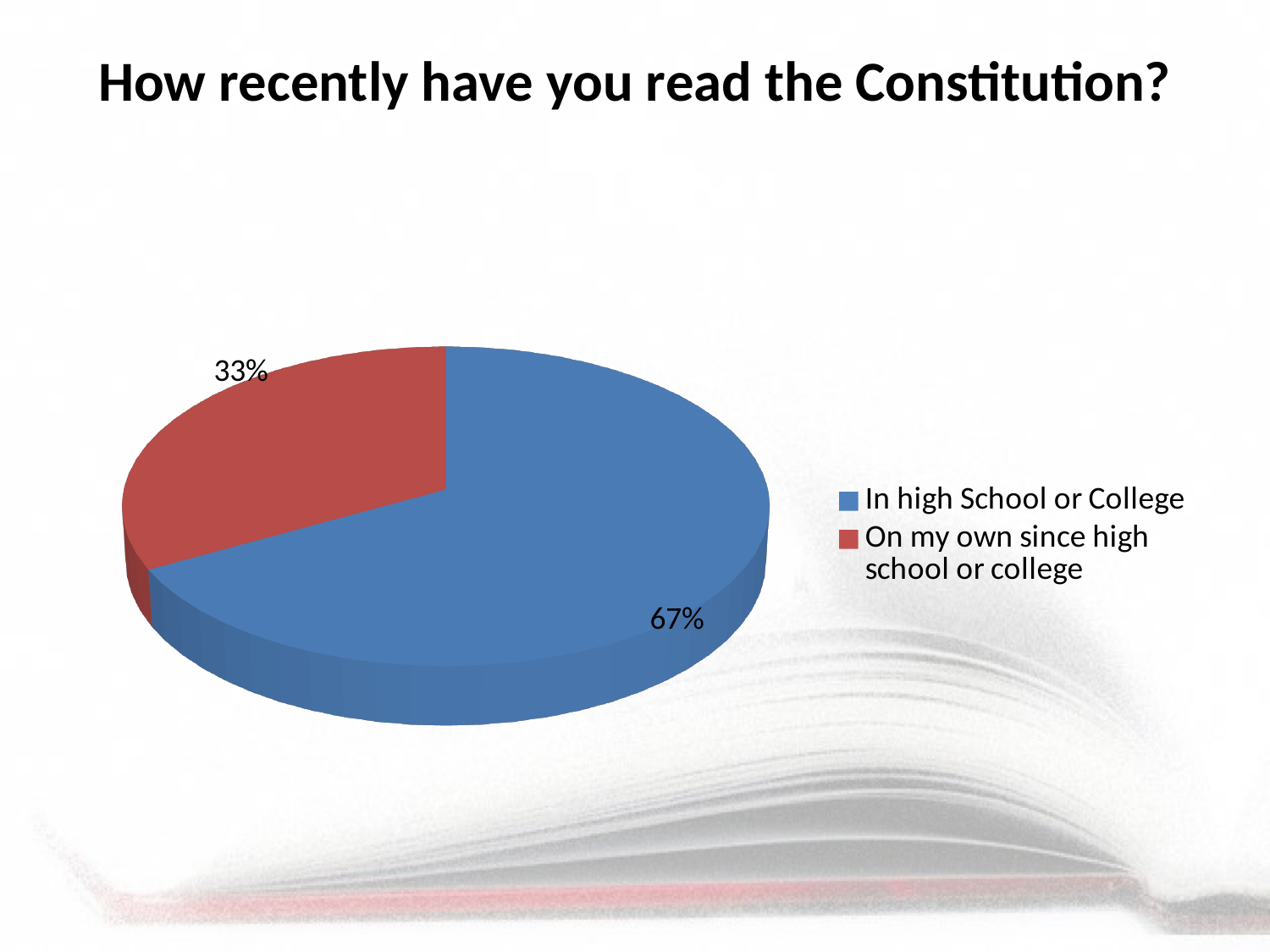
What is the title of the slide? How recently have you read the Constitution? Which category has the largest share of the pie? In high School or College What kind of chart is shown on the slide? Pie chart How many entries does the legend list? 2 How many slices does the pie chart have? 2 What share of the pie does the red slice represent? 33% What percentage of respondents read the Constitution in high school or college? 67% What colour is the slice for 'In high School or College'? Blue What percentage of respondents read the Constitution on their own since high school or college? 33% What is the difference in percentage points between the 'In high School or College' slice and the 'On my own since high school or college' slice? 34 Which category has the smallest share of the pie? On my own since high school or college Which is larger: the share for 'In high School or College' or the share for 'On my own since high school or college'? In high School or College